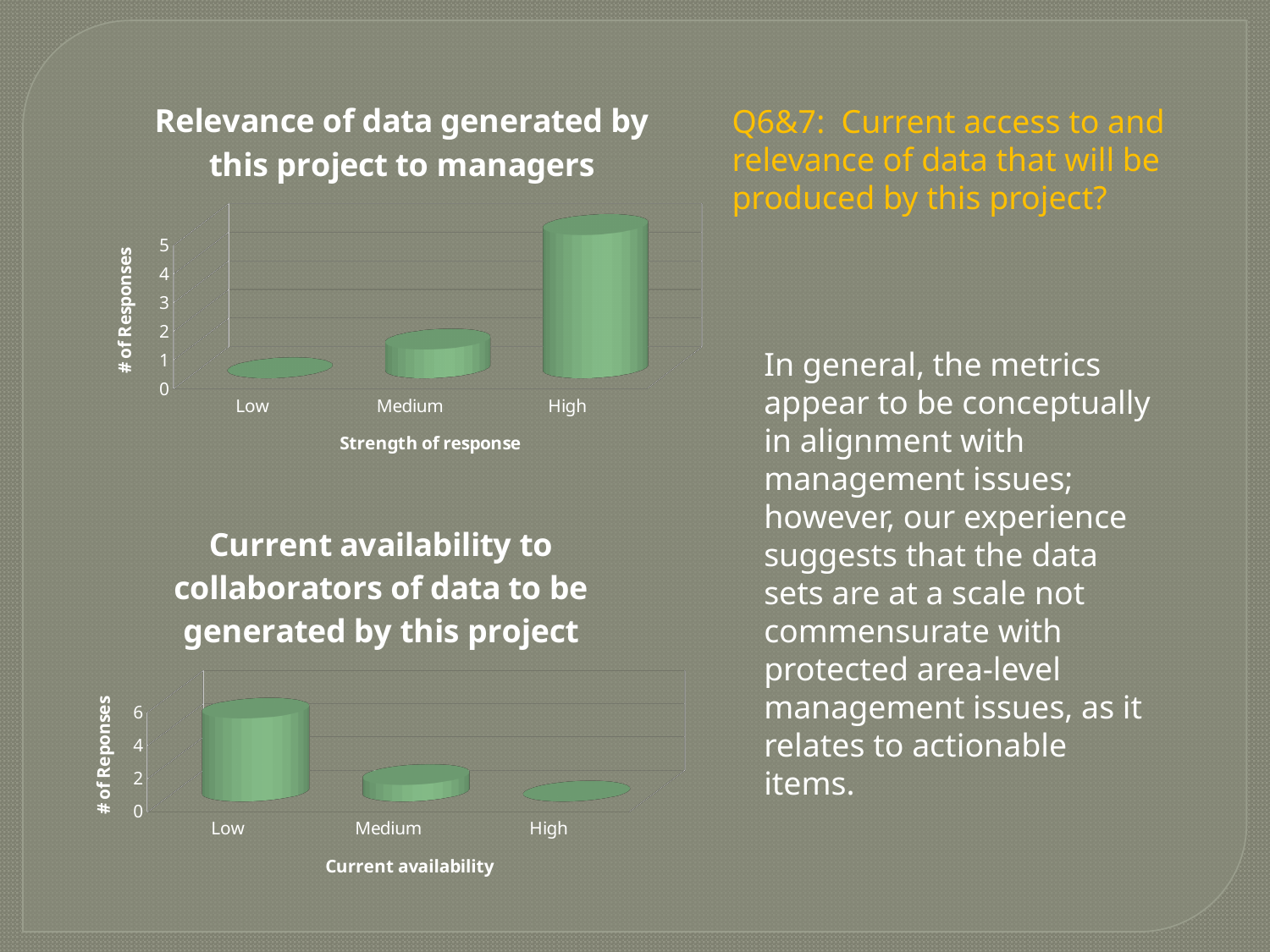
In the chart titled 'Current availability to collaborators of data to be generated by this project', is the value for Low greater or less than 4? greater In the chart titled 'Current availability to collaborators of data to be generated by this project', which category has the highest number of responses? Low In the chart titled 'Current availability to collaborators of data to be generated by this project', is the value for Medium greater or less than 4? less What is the x-axis title of the bottom chart? Current availability In the chart titled 'Relevance of data generated by this project to managers', is the value for Medium greater or less than 3? less How many categories are shown on the x axis of the top chart? 3 In the chart titled 'Relevance of data generated by this project to managers', do the values rise or fall from Low to High? rise In the chart titled 'Current availability to collaborators of data to be generated by this project', which category has the lowest number of responses? High In the chart titled 'Relevance of data generated by this project to managers', which category has the highest number of responses? High In the chart titled 'Relevance of data generated by this project to managers', which category has the lowest number of responses? Low In the chart titled 'Current availability to collaborators of data to be generated by this project', do the values rise or fall from Low to High? fall